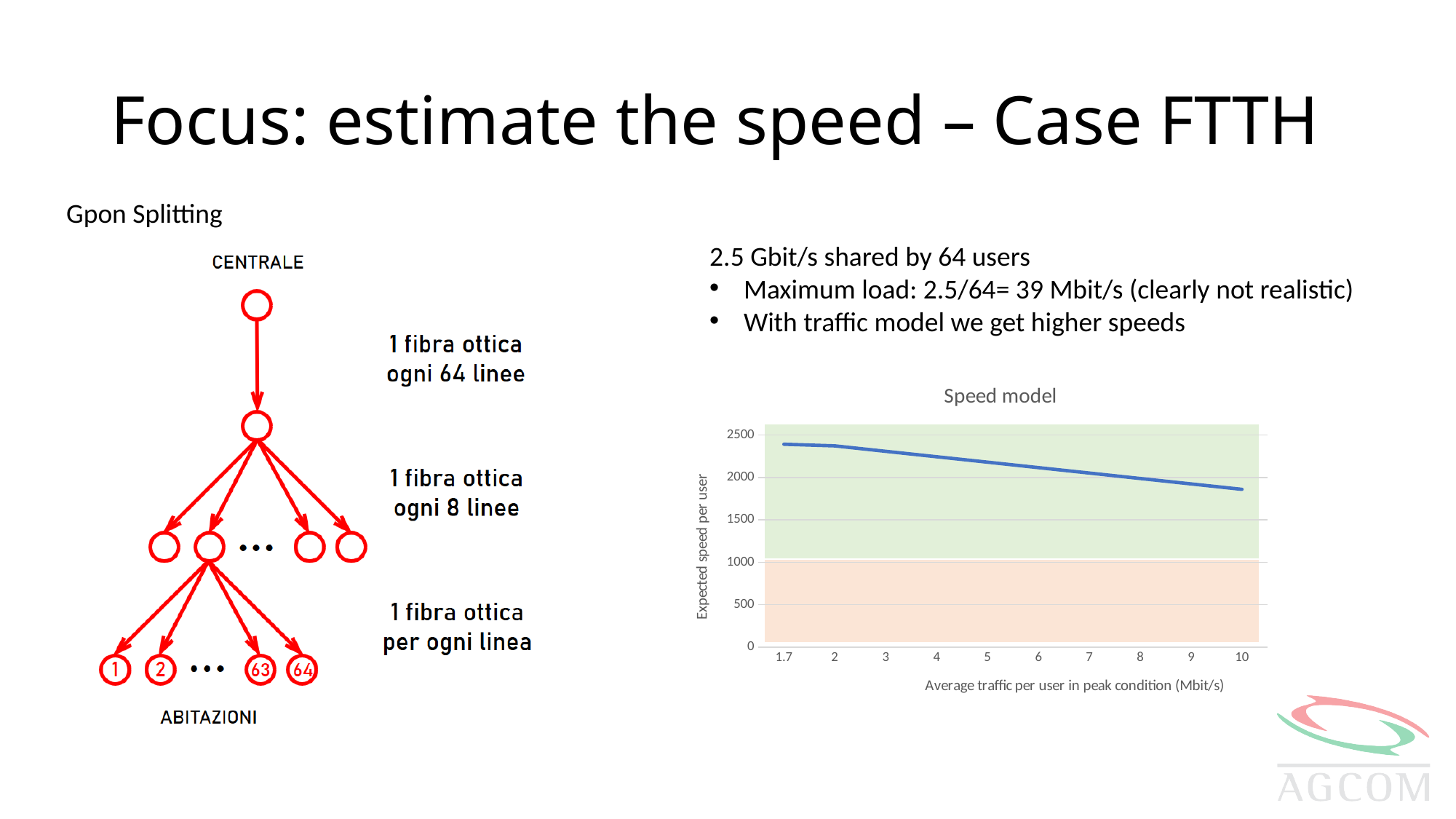
In the "Speed model" chart, at which x-axis value is the expected speed per user highest? 1.7 In the "Speed model" chart, is the expected speed per user at 10 Mbit/s average traffic greater or less than 2000? less In the "Speed model" chart, is the expected speed per user at 10 Mbit/s average traffic greater or less than 1500? greater What is the x-axis label of the "Speed model" chart? Average traffic per user in peak condition (Mbit/s) In the "Speed model" chart, does the expected speed per user rise or fall as average traffic per user increases along the x axis? fall In the "Speed model" chart, is the expected speed per user at 5 Mbit/s average traffic greater or less than 1500? greater How many x-axis tick values are shown on the "Speed model" chart? 10 In the "Speed model" chart, at which x-axis value is the expected speed per user lowest? 10 What is the title of the chart on the slide? Speed model What kind of chart is the "Speed model" chart? line chart In the "Speed model" chart, is the expected speed per user higher at 2 Mbit/s or at 9 Mbit/s average traffic? 2 Mbit/s